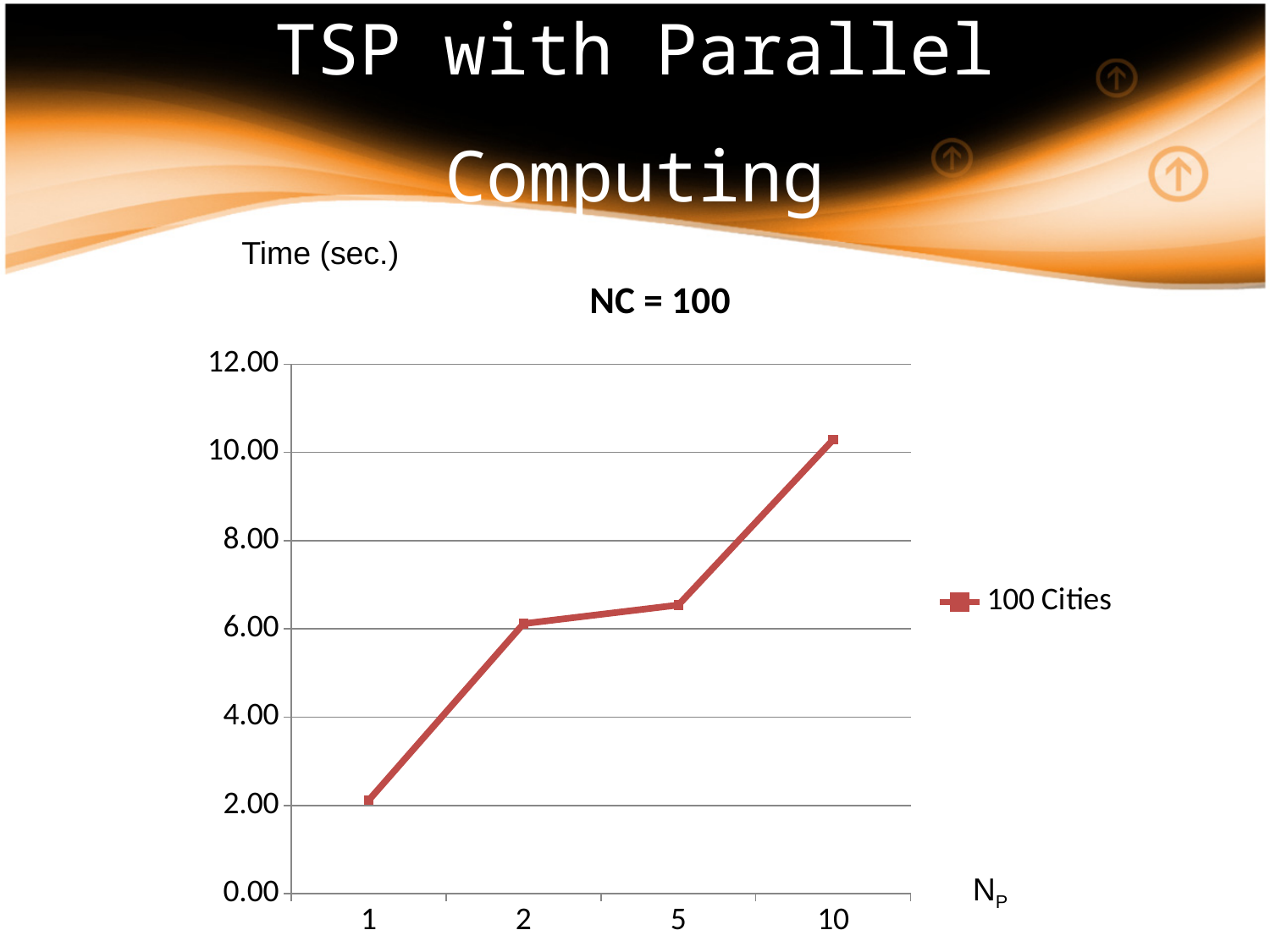
How many series does the legend list? 1 At which x-axis value is the time lowest? 1 What is the title of the chart? NC = 100 What is the name of the series shown in the legend? 100 Cities Is the value at x = 1 greater or less than 4.00? less At which x-axis value is the time highest? 10 How many data points are plotted on the line? 4 Is the value at x = 5 greater or less than 6.00? greater What kind of chart is shown on the slide? line chart Do the values rise or fall as the x axis goes from 1 to 10? rise Which has the larger value, x = 1 or x = 10? 10 Is the value at x = 10 greater or less than 8.00? greater